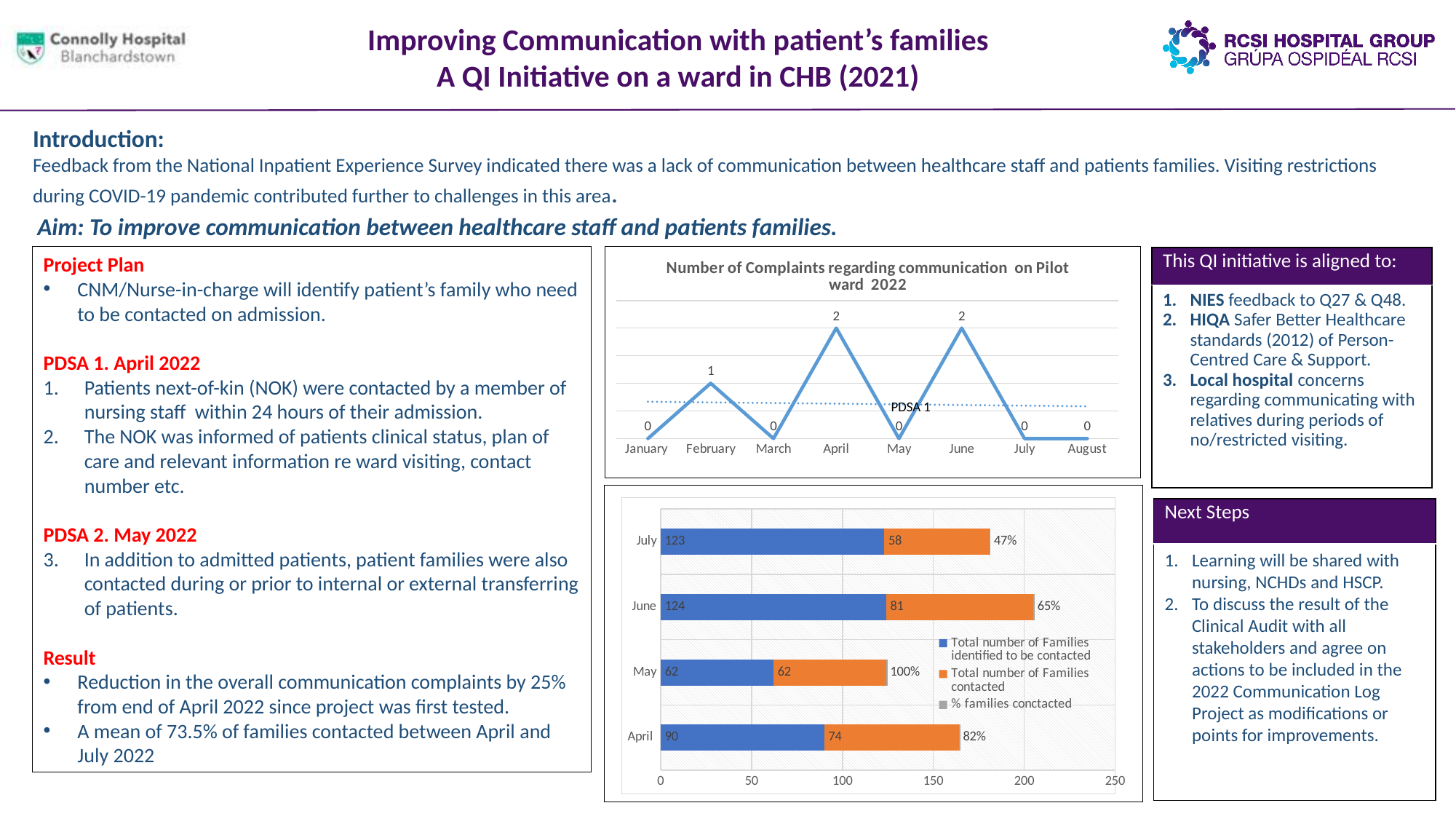
In the 'Number of Complaints regarding communication on Pilot ward 2022' chart, what is the difference between the complaints in June and in February? 1 In the bottom stacked bar chart, what percentage of families was contacted in May? 100% What kind of chart is the 'Number of Complaints regarding communication on Pilot ward 2022' chart? Line chart How many series does the legend of the bottom stacked bar chart list? 3 In the 'Number of Complaints regarding communication on Pilot ward 2022' chart, how many months are plotted on the x axis? 8 In the bottom stacked bar chart, what is the difference between the number of families identified to be contacted and the number contacted in April? 16 In the bottom stacked bar chart, which month has the lowest total number of families identified to be contacted? May In the bottom stacked bar chart, what is the total number of families identified to be contacted in June? 124 In the bottom stacked bar chart, what is the total number of families contacted in July? 58 In the 'Number of Complaints regarding communication on Pilot ward 2022' chart, how many complaints were recorded in February? 1 In the 'Number of Complaints regarding communication on Pilot ward 2022' chart, which months have the highest number of complaints? April and June In the 'Number of Complaints regarding communication on Pilot ward 2022' chart, how many complaints were recorded in April? 2